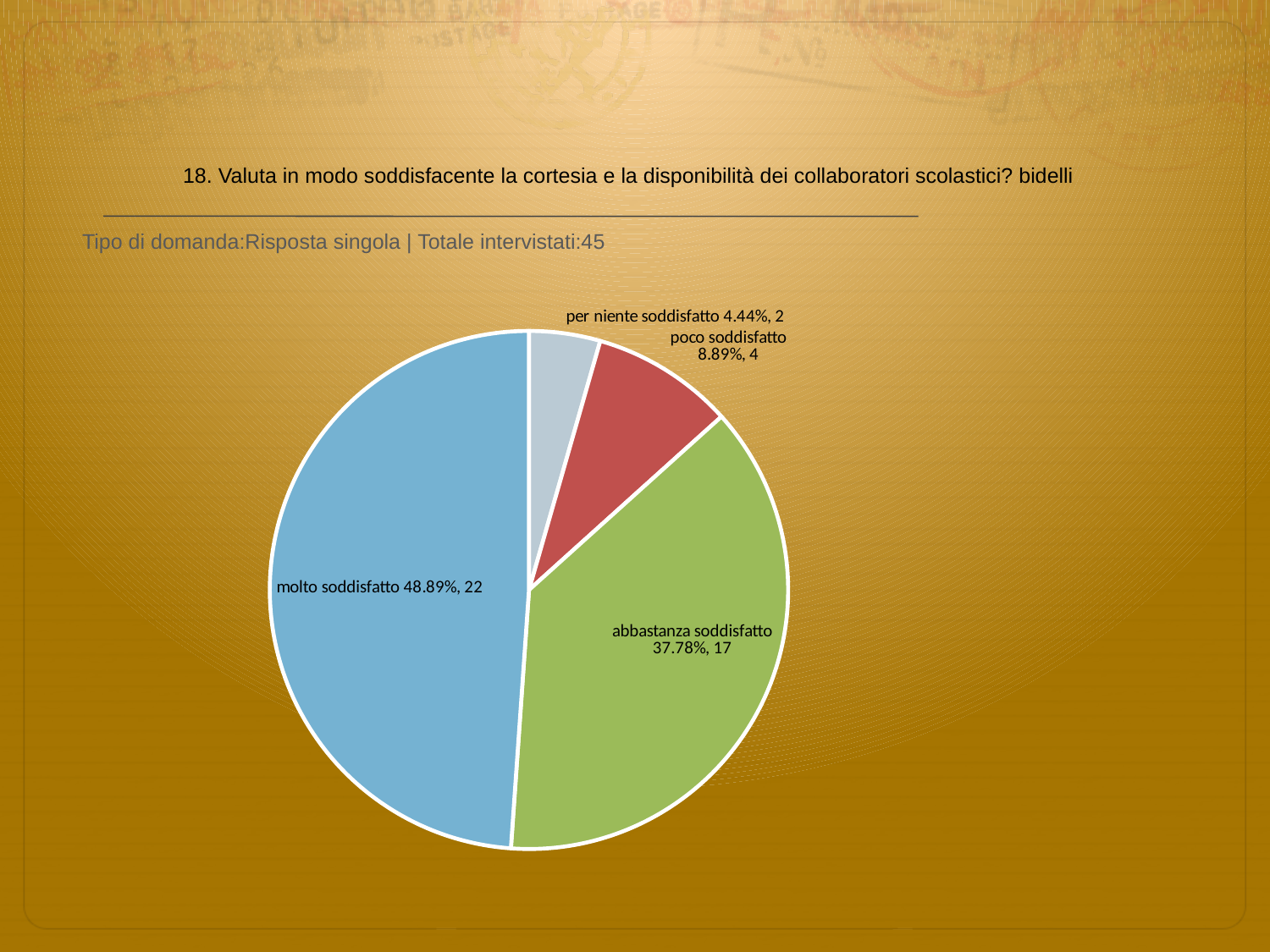
What is the total number of respondents shown on the slide? 45 What colour is the 'abbastanza soddisfatto' slice? green What is the difference in respondent count between 'molto soddisfatto' and 'abbastanza soddisfatto'? 5 How many slices does the pie chart have? 4 Which category has the smallest slice of the pie? per niente soddisfatto How many respondents answered 'abbastanza soddisfatto'? 17 Which has more respondents, 'poco soddisfatto' or 'per niente soddisfatto'? poco soddisfatto Which category has the largest slice of the pie? molto soddisfatto What percentage share does the 'molto soddisfatto' slice have? 48.89% What kind of chart is shown on the slide? pie chart What percentage share does the 'poco soddisfatto' slice have? 8.89% How many respondents answered 'per niente soddisfatto'? 2